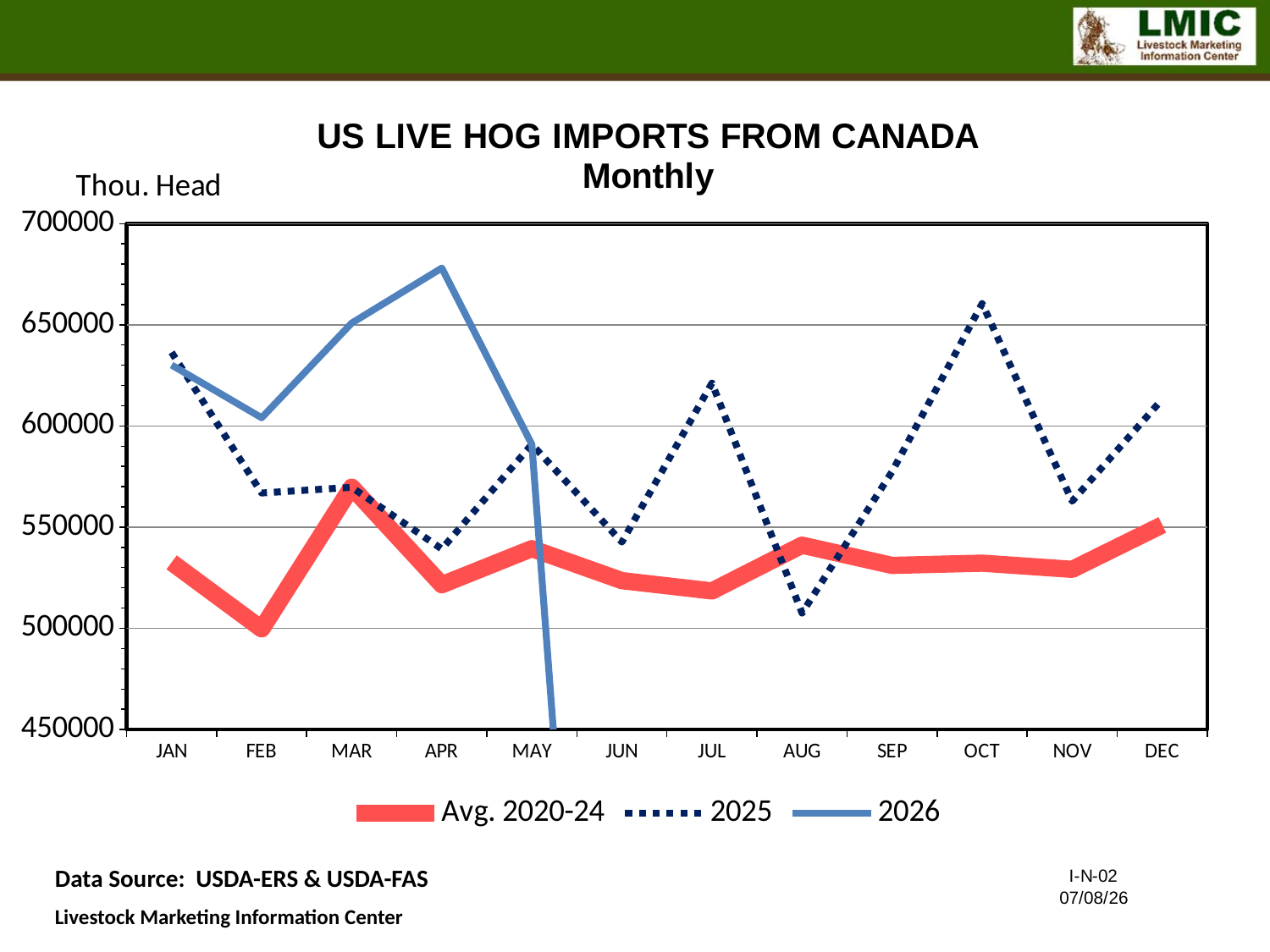
What unit is shown on the y axis label? Thou. Head Which month has the lowest value for the Avg. 2020-24 series? FEB What kind of chart is shown on the slide? line chart Is the value for 2025 in AUG greater or less than 550000? less How many months are shown along the x axis? 12 How many series does the legend list? 3 Which month has the lowest value for the 2025 series? AUG In MAR, which series has the larger value, 2025 or 2026? 2026 Is the value for 2026 in APR greater or less than 650000? greater Does the 2026 series rise or fall from FEB to APR? rise Which month has the highest value for the 2026 series? APR Which month has the highest value for the Avg. 2020-24 series? MAR